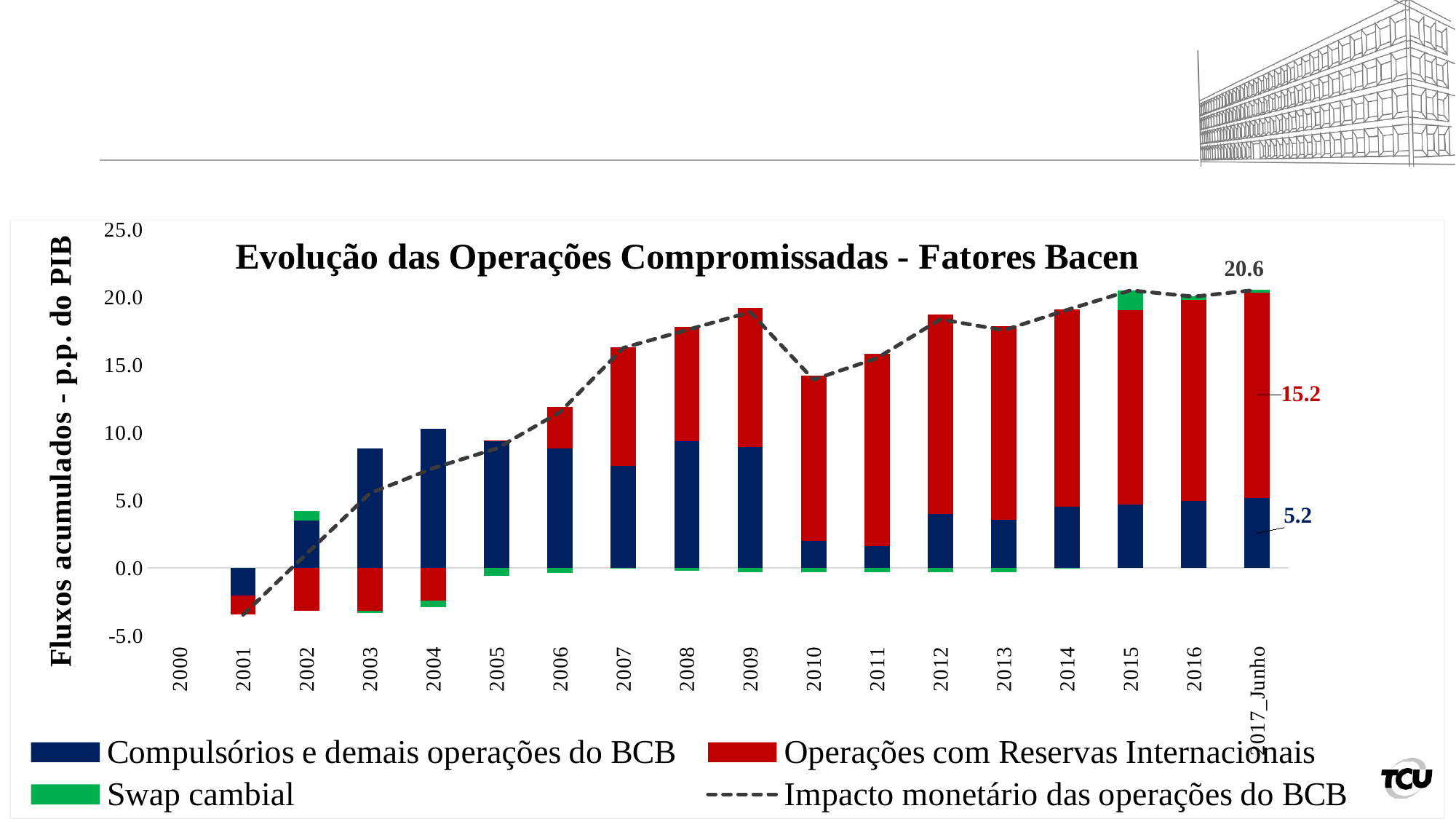
What is the value of Operações com Reservas Internacionais for 2017_Junho? 15.2 How many years (categories) are shown on the x axis? 18 What kind of chart is shown on the slide? A stacked bar chart with a dashed line What is the value of Compulsórios e demais operações do BCB for 2017_Junho? 5.2 Does the Impacto monetário das operações do BCB line rise or fall from 2001 to 2009? rise How many series does the legend list? 4 In 2017_Junho, what is the difference between Operações com Reservas Internacionais and Compulsórios e demais operações do BCB? 10.0 Is the value of Impacto monetário das operações do BCB for 2010 greater or less than 15.0? less What is the value of Impacto monetário das operações do BCB for 2017_Junho? 20.6 Is the value of Compulsórios e demais operações do BCB for 2003 greater or less than 10.0? less What is the title of the chart? Evolução das Operações Compromissadas - Fatores Bacen Which year has the lowest value of Impacto monetário das operações do BCB? 2001